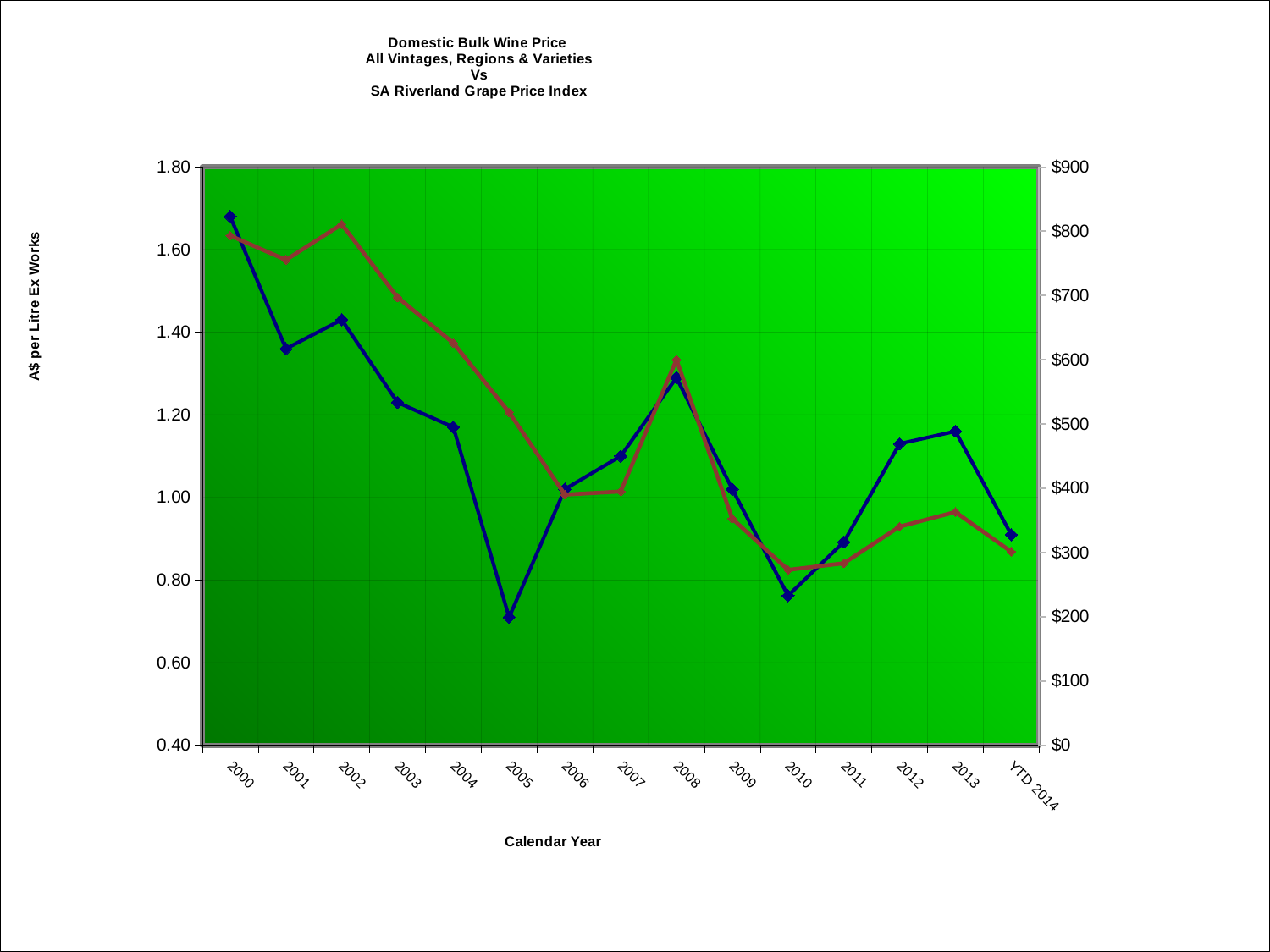
In which year does the blue line reach its lowest point? 2005 How many lines are plotted on the chart? 2 Is the red line's value for 2008 greater or less than $500 on the right axis? greater Is the red line's value for 2009 greater or less than $400 on the right axis? less Is the blue line's value for 2005 greater or less than 0.80 on the left axis? less In which year does the blue line reach its highest point? 2000 What kind of chart is shown on the slide? line chart Overall, do the plotted values rise or fall from 2000 to YTD 2014? fall What is the label of the x axis? Calendar Year How many calendar-year points are plotted along the x axis? 15